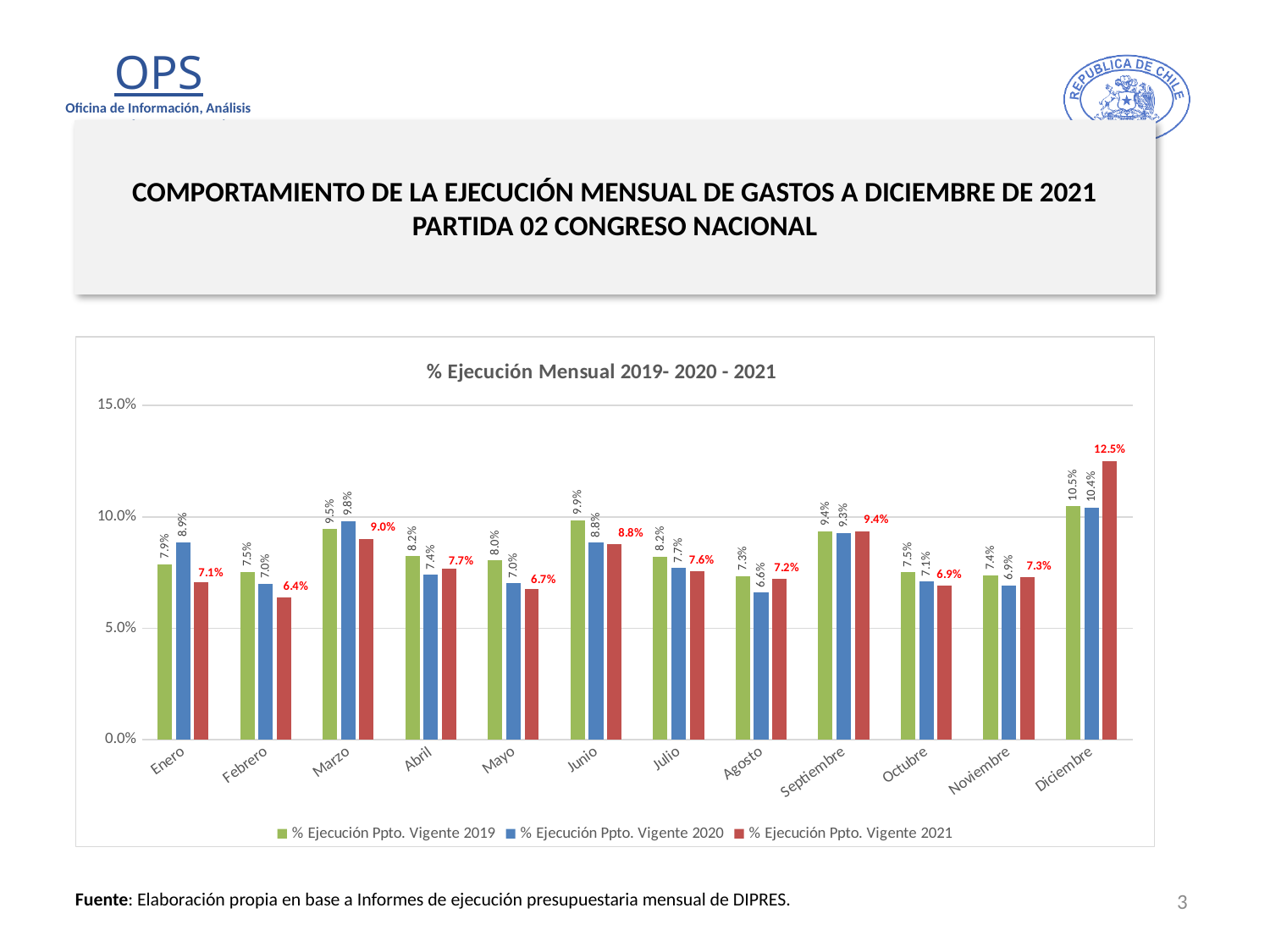
What is the value for % Ejecución Ppto. Vigente 2021 in Diciembre? 12.5% Which month has the lowest value for % Ejecución Ppto. Vigente 2021? Febrero What is the value for % Ejecución Ppto. Vigente 2019 in Junio? 9.9% Which month has the highest value for % Ejecución Ppto. Vigente 2021? Diciembre What is the difference between the 2021 and 2020 values in Diciembre? 2.1% Which month has the lowest value for % Ejecución Ppto. Vigente 2020? Agosto What kind of chart is shown? Bar chart How many months are shown on the x axis? 12 Is the value for % Ejecución Ppto. Vigente 2019 in Diciembre greater or less than 10.0%? greater In Enero, which is larger: the 2019 value or the 2020 value? 2020 How many series does the legend list? 3 What is the value for % Ejecución Ppto. Vigente 2020 in Marzo? 9.8%